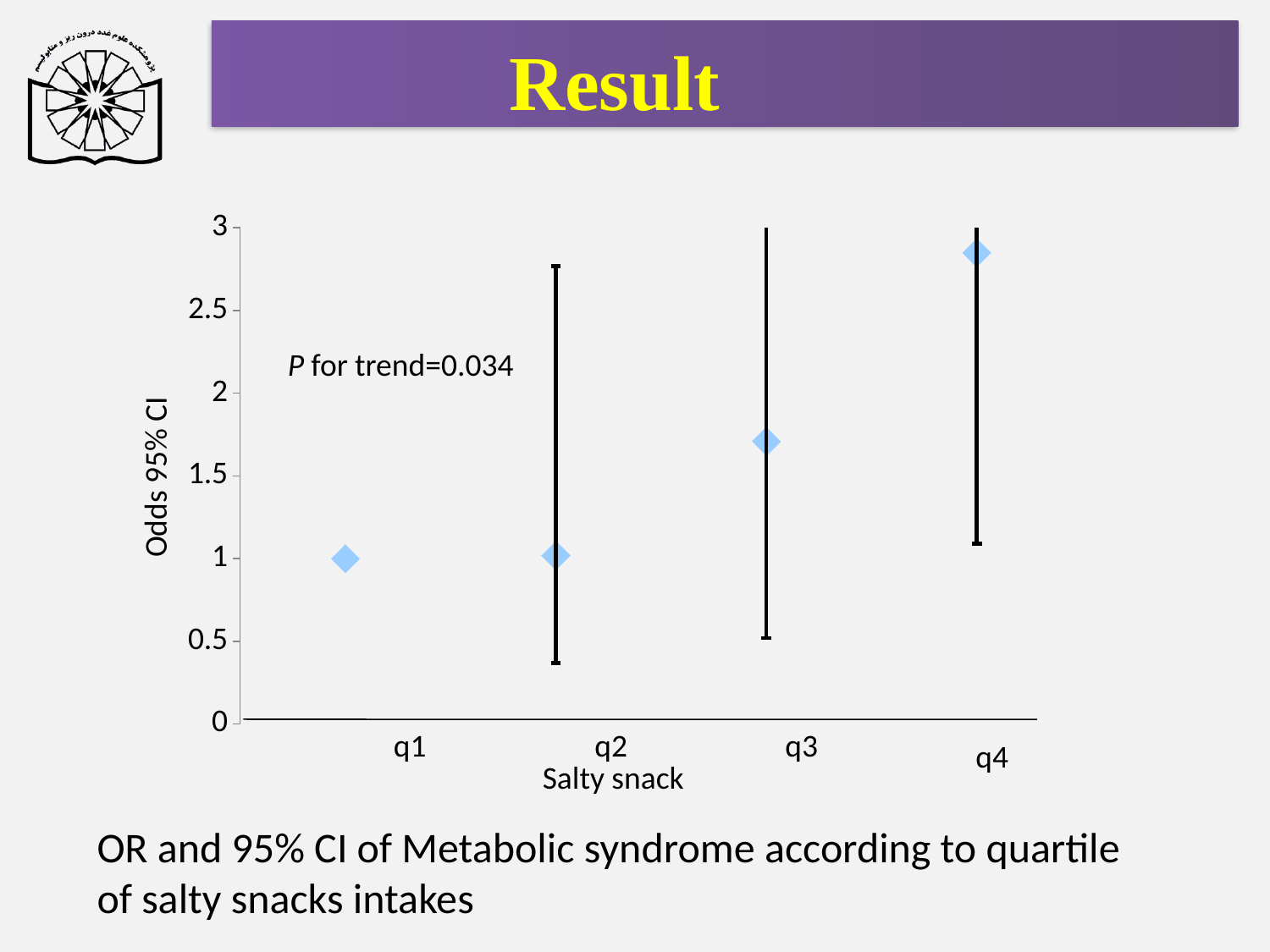
How many quartile categories are plotted on the x axis? 4 What kind of chart is shown on the slide? scatter chart with error bars Is the odds ratio for q4 greater or less than 2.5? greater Which has the larger odds ratio, q3 or q4? q4 What P for trend value is printed on the chart? 0.034 What is the title of the x axis? Salty snack Is the odds ratio for q3 greater or less than 1.5? greater Do the odds ratios rise or fall from q1 to q4? rise Which quartile has the highest odds ratio? q4 Is the odds ratio for q2 greater or less than 1.5? less Which has the larger odds ratio, q2 or q3? q3